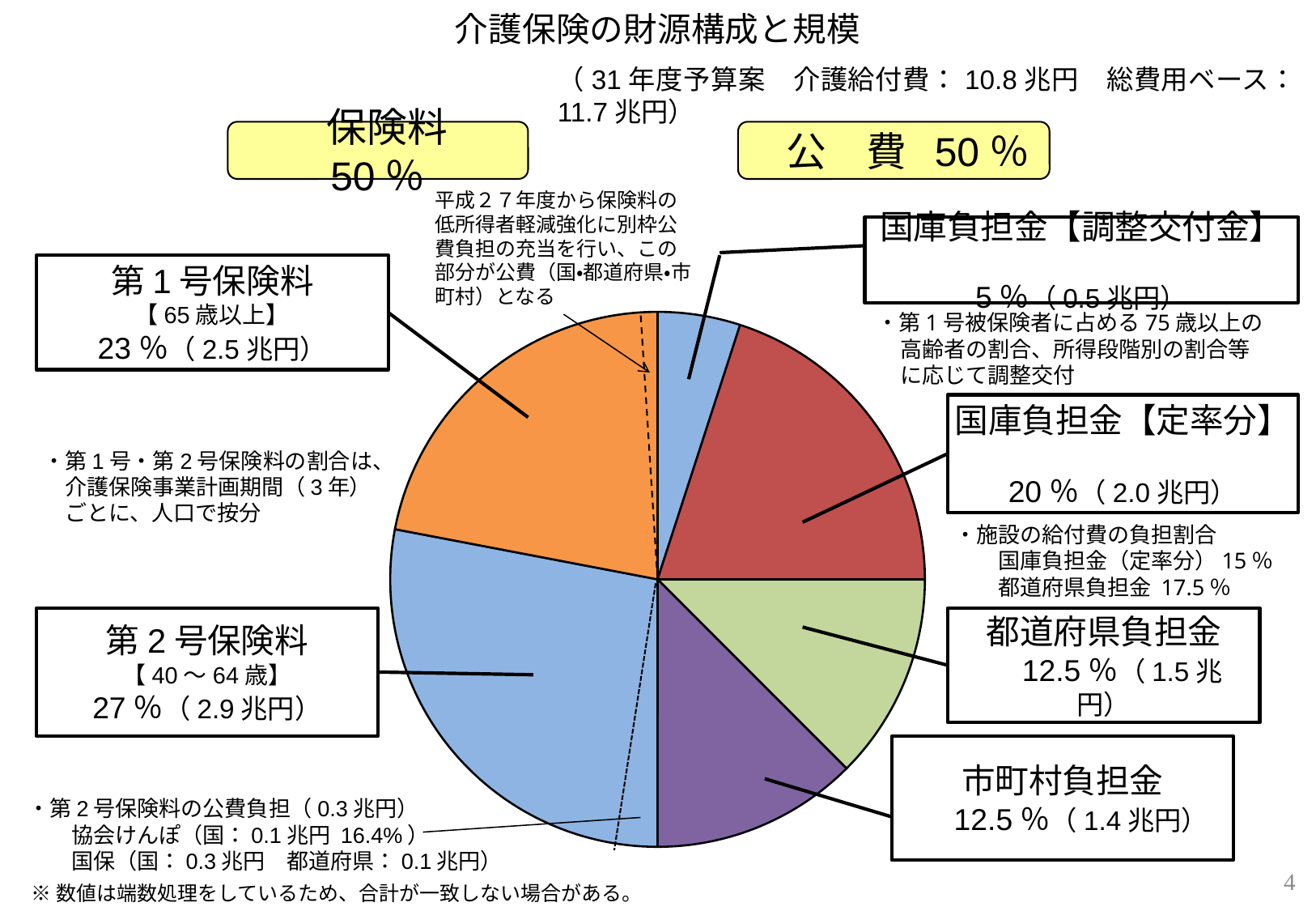
What is the title of the slide's chart? 介護保険の財源構成と規模 What percentage share does 国庫負担金【定率分】 account for? 20% What kind of chart is shown on the slide? pie chart What is the amount shown for 市町村負担金? 1.4兆円 How many slices does the pie chart have? 6 What is the difference in percentage points between 第2号保険料 and 第1号保険料? 4 What is the amount shown for 第2号保険料? 2.9兆円 What total share of the pie do the 保険料 slices (第1号保険料 and 第2号保険料) make up, as labelled on the slide? 50% Which slice of the pie chart is the smallest? 国庫負担金【調整交付金】 What percentage share does 第1号保険料 account for? 23% Which is larger, the share of 国庫負担金【定率分】 or the share of 都道府県負担金? 国庫負担金【定率分】 Which slice of the pie chart is the largest? 第2号保険料